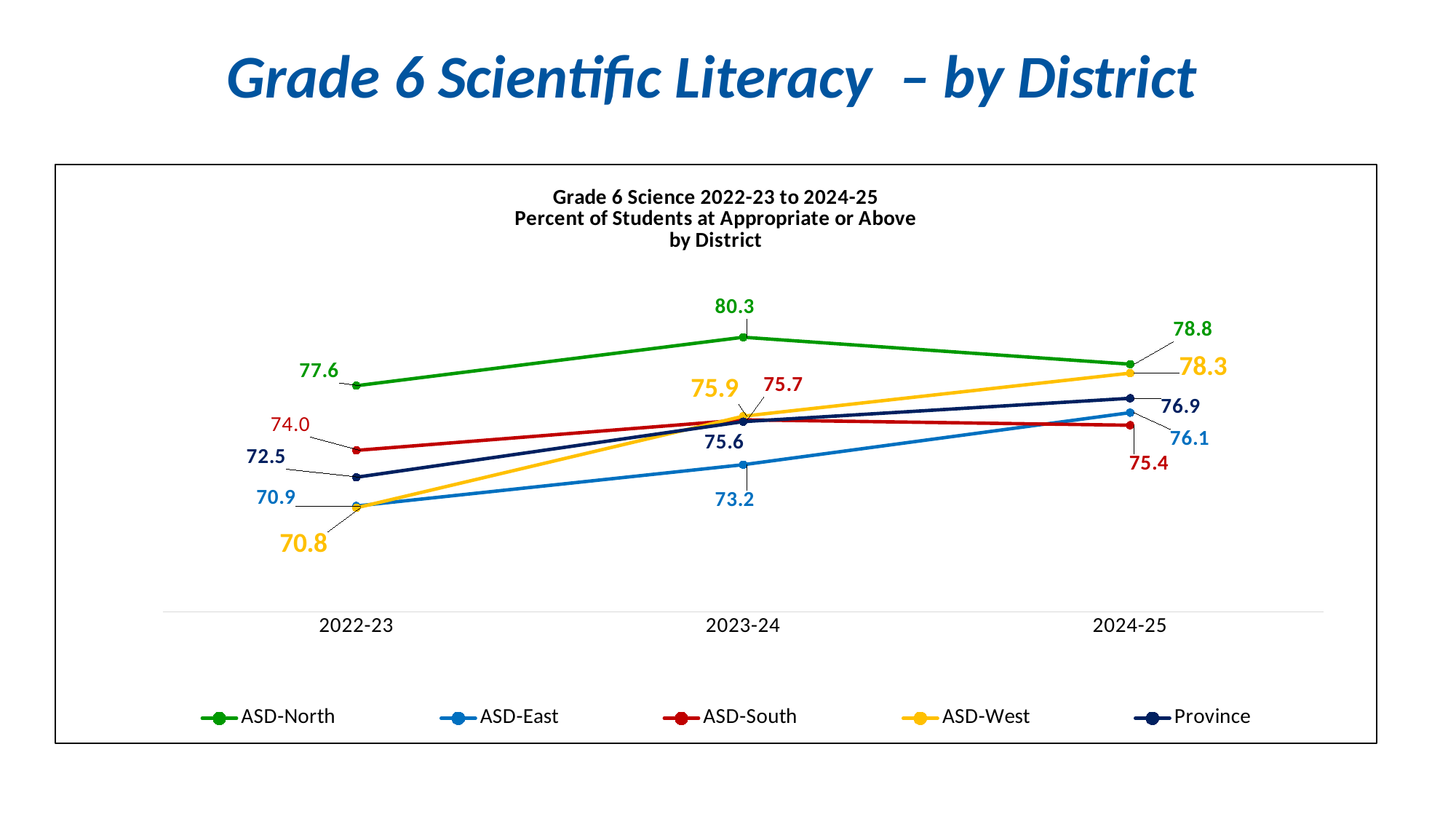
How many series does the legend list? 5 What kind of chart is this? Line chart What is the value for ASD-West in 2022-23? 70.8 What is the difference between ASD-North and ASD-East in 2022-23? 6.7 Which district has the highest value in 2024-25? ASD-North What is the value for ASD-East in 2023-24? 73.2 What is the value for ASD-North in 2023-24? 80.3 Which is larger in 2024-25, ASD-West or ASD-South? ASD-West How many school years are shown on the x axis? 3 Which series has the lowest value in 2022-23? ASD-West What is the Province value in 2024-25? 76.9 Does the ASD-East line rise or fall from 2022-23 to 2024-25? Rises